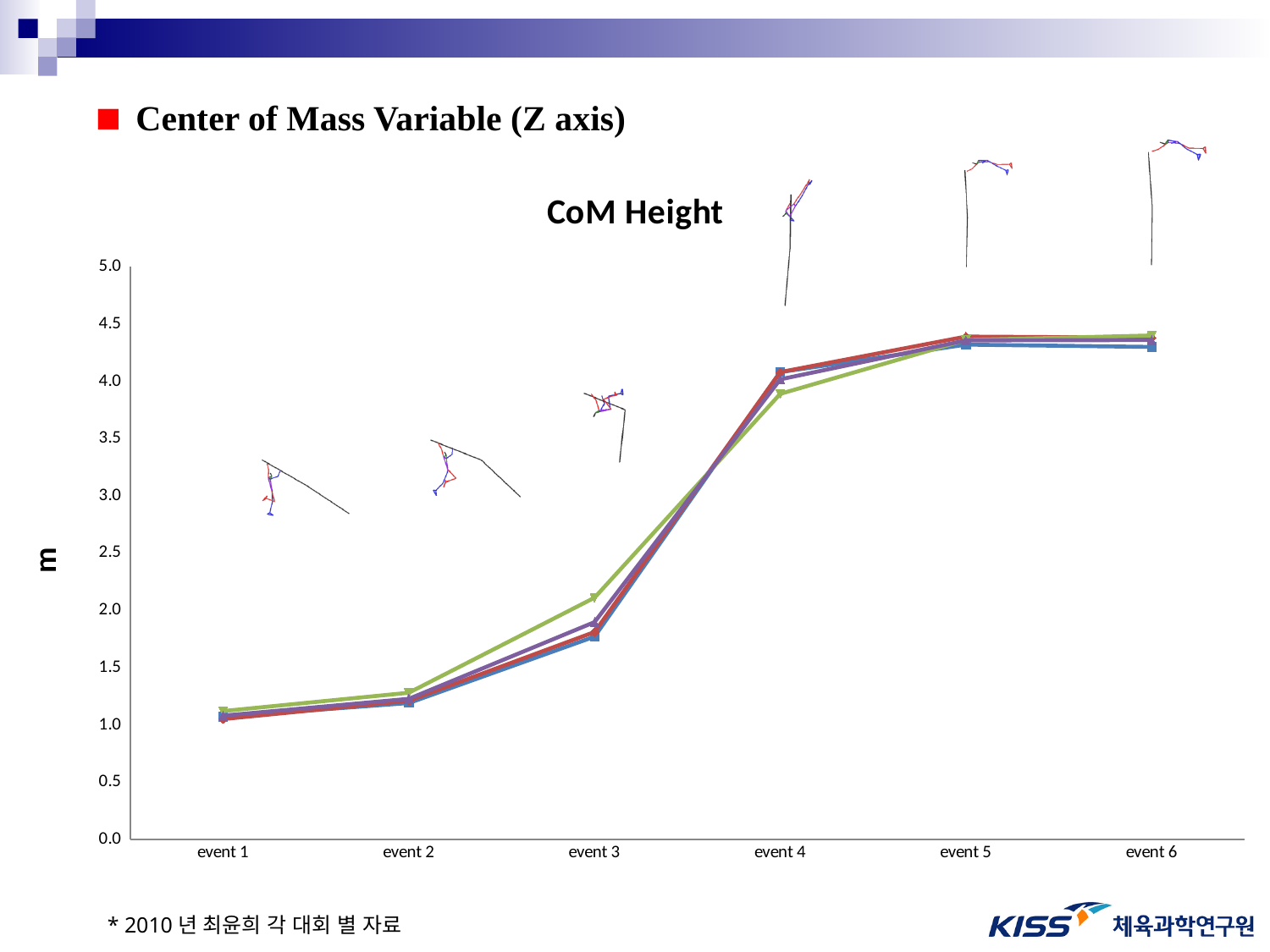
What kind of chart is the CoM Height chart? line chart How many events are shown on the x axis of the CoM Height chart? 6 How many lines are plotted on the CoM Height chart? 4 Which event has the lowest CoM Height values? event 1 Do the CoM Height values rise or fall from event 1 to event 5? rise What is the label on the y axis of the chart? m Are the values at event 3 greater or less than 2.5? less What is the title of the chart? CoM Height Are the values at event 5 greater or less than 4.0? greater Are the values at event 1 greater or less than 1.5? less At event 3, is the green line higher or lower than the blue line? higher